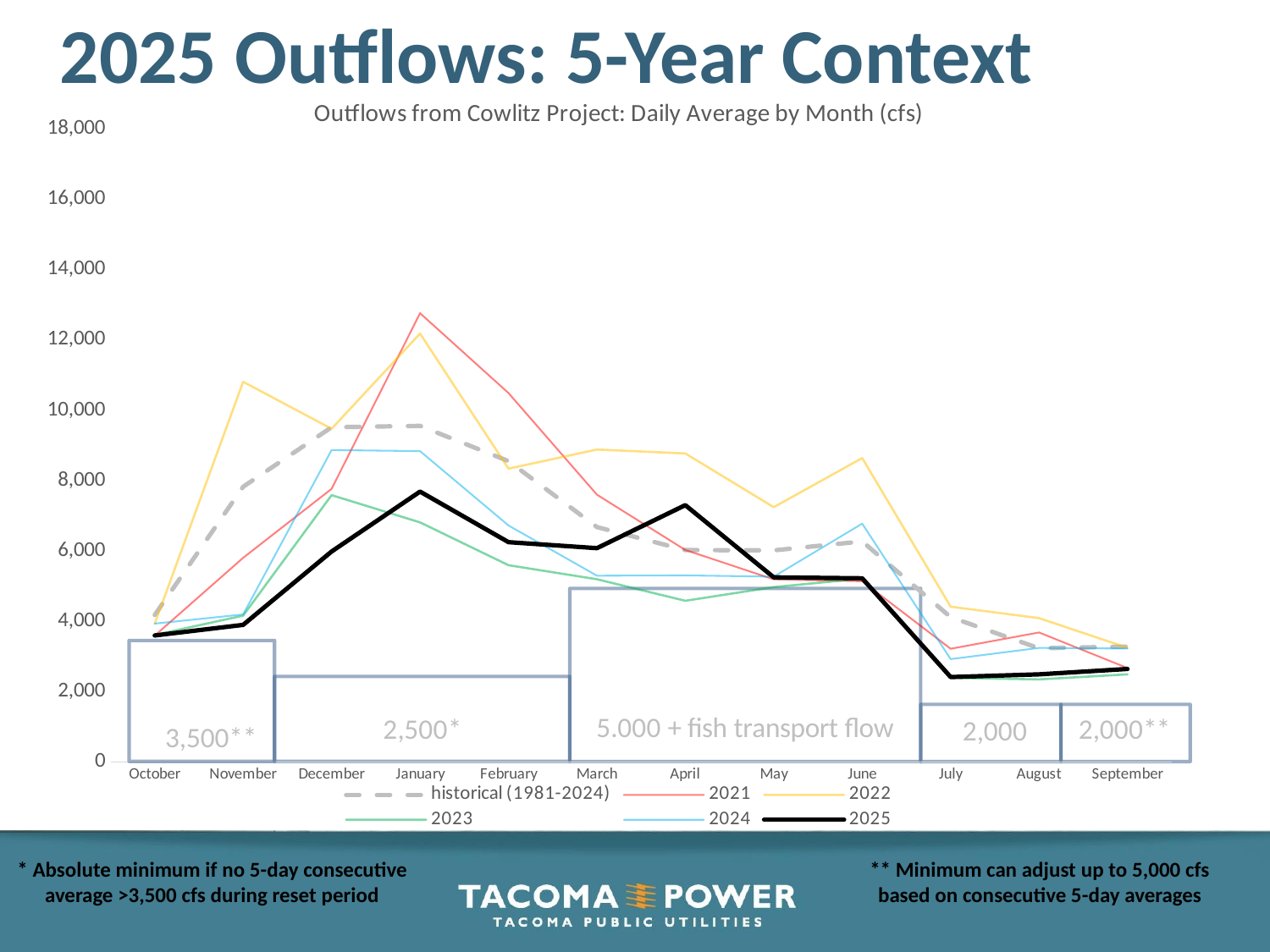
Is the 2021 value for January greater or less than 12,000? greater Does the 2025 line rise or fall from June to July? fall Which is larger, the 2022 value for June or the 2025 value for June? 2022 Is the 2025 value for January greater or less than 6,000? greater Is the 2022 value for November greater or less than 10,000? greater How many months are shown along the x axis? 12 What is the title of the chart? Outflows from Cowlitz Project: Daily Average by Month (cfs) Which series is drawn as a dashed grey line? historical (1981-2024) What kind of chart is shown on the slide? line chart Which series has the highest value in November? 2022 How many series does the legend list? 6